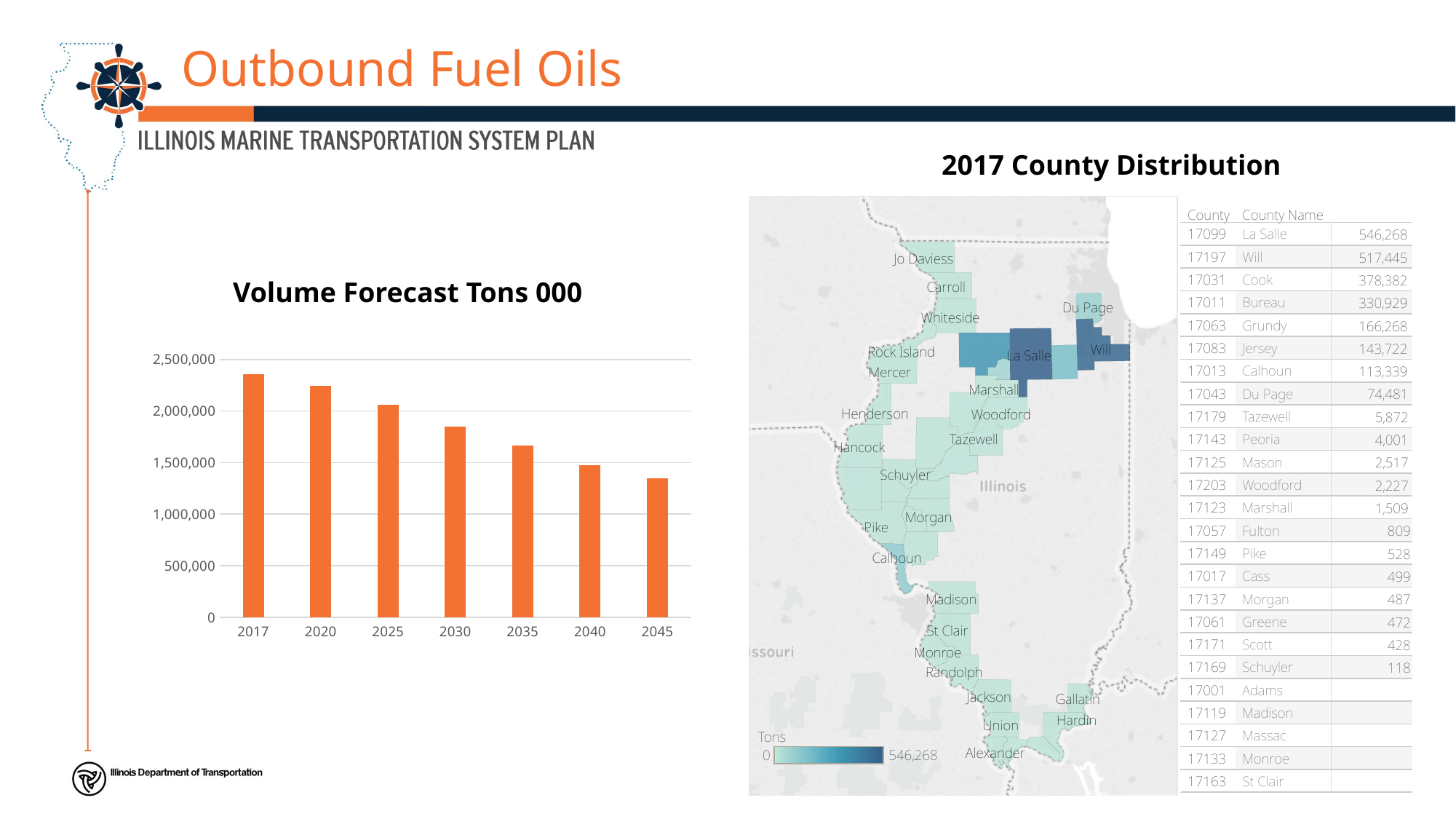
In the Volume Forecast Tons 000 chart, which is larger, the value for 2020 or the value for 2030? 2020 What is the title of the bar chart on the left of the slide? Volume Forecast Tons 000 In the Volume Forecast Tons 000 chart, which year has the highest value? 2017 In the Volume Forecast Tons 000 chart, do the values rise or fall from 2017 to 2045? fall How many years are shown on the x axis of the Volume Forecast Tons 000 chart? 7 What colour are the bars in the Volume Forecast Tons 000 chart? orange In the Volume Forecast Tons 000 chart, which year has the lowest value? 2045 In the Volume Forecast Tons 000 chart, is the value for 2035 greater or less than 1,500,000? greater What kind of chart is the Volume Forecast Tons 000 chart? bar chart In the Volume Forecast Tons 000 chart, is the value for 2030 greater or less than 2,000,000? less In the Volume Forecast Tons 000 chart, is the value for 2045 greater or less than 1,500,000? less